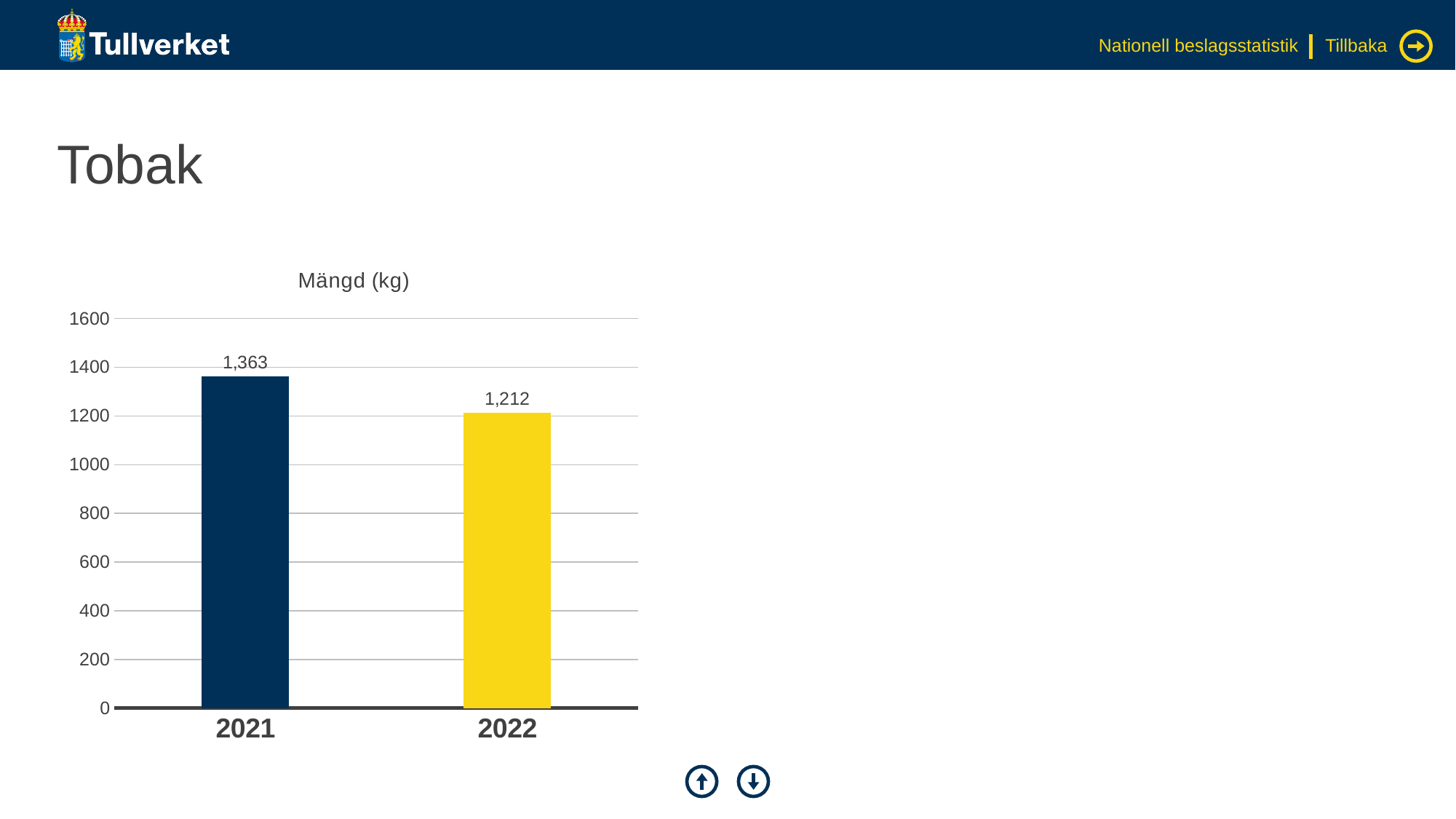
What is the value for 2021 in the Mängd (kg) chart? 1,363 What kind of chart is shown on the slide? bar chart How many years are shown in the Mängd (kg) chart? 2 What is the difference between the 2021 and 2022 values in the Mängd (kg) chart? 151 Which is larger in the Mängd (kg) chart, the value for 2021 or 2022? 2021 Do the values rise or fall from 2021 to 2022? fall Is the value for 2021 greater or less than 1200? greater Which year has the highest value in the Mängd (kg) chart? 2021 Which year has the lowest value in the Mängd (kg) chart? 2022 What is the title of the chart on the slide? Mängd (kg) Is the value for 2022 greater or less than 1400? less What is the value for 2022 in the Mängd (kg) chart? 1,212